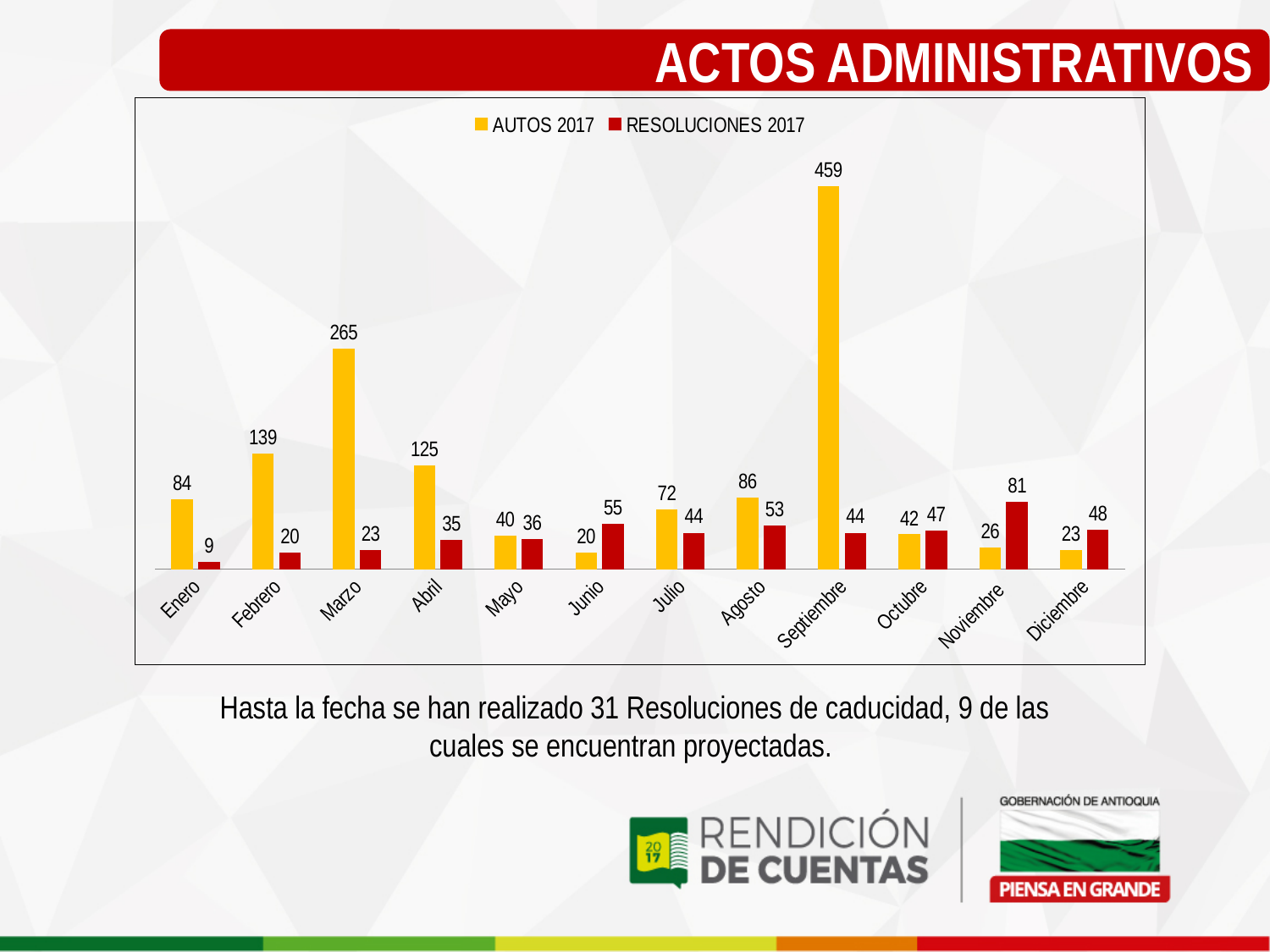
What is the difference between AUTOS 2017 and RESOLUCIONES 2017 in Febrero? 119 Which is larger in Junio, AUTOS 2017 or RESOLUCIONES 2017? RESOLUCIONES 2017 What kind of chart is shown on the slide? Bar chart How many months are shown on the x axis? 12 What is the value of RESOLUCIONES 2017 for Noviembre? 81 Which month has the lowest value for RESOLUCIONES 2017? Enero What is the value of RESOLUCIONES 2017 for Diciembre? 48 What colour represents RESOLUCIONES 2017 in the chart? Red What is the value of AUTOS 2017 for Marzo? 265 Which month has the highest value for AUTOS 2017? Septiembre What is the value of AUTOS 2017 for Septiembre? 459 How many series does the legend list? 2